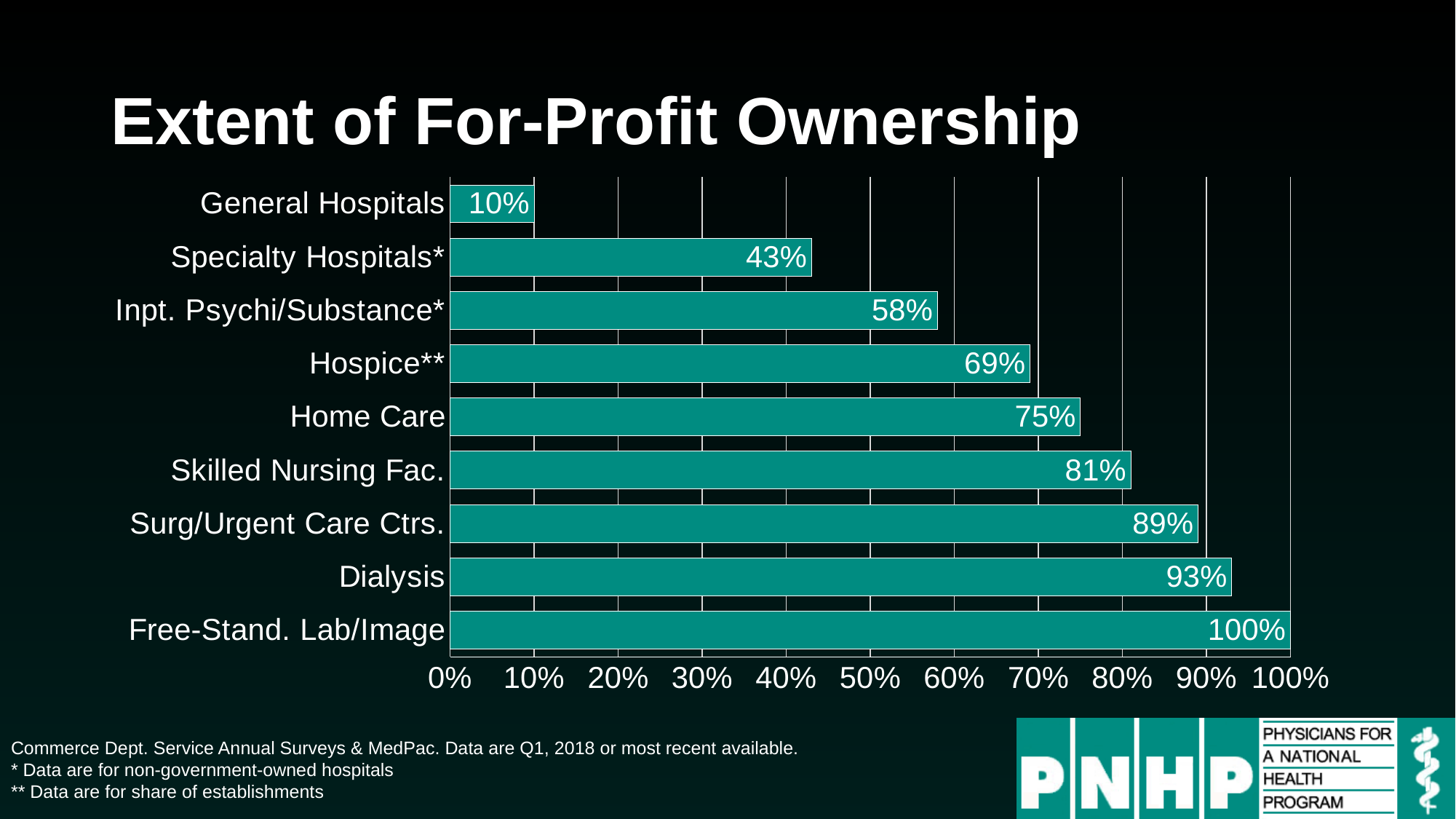
What is the difference between the values for Surg/Urgent Care Ctrs. and General Hospitals? 79% What is the title of the chart? Extent of For-Profit Ownership What is the value shown for Dialysis? 93% What is the difference between the values for Skilled Nursing Fac. and Hospice**? 12% Is the value for Hospice** greater or less than 60%? greater What is the for-profit ownership value for Home Care? 75% How many categories are shown in the chart? 9 What is the value shown for Specialty Hospitals*? 43% Which category has the lowest for-profit ownership? General Hospitals Which category has the highest for-profit ownership? Free-Stand. Lab/Image Which is larger, the value for Inpt. Psychi/Substance* or the value for Home Care? Home Care What kind of chart is shown on the slide? Bar chart